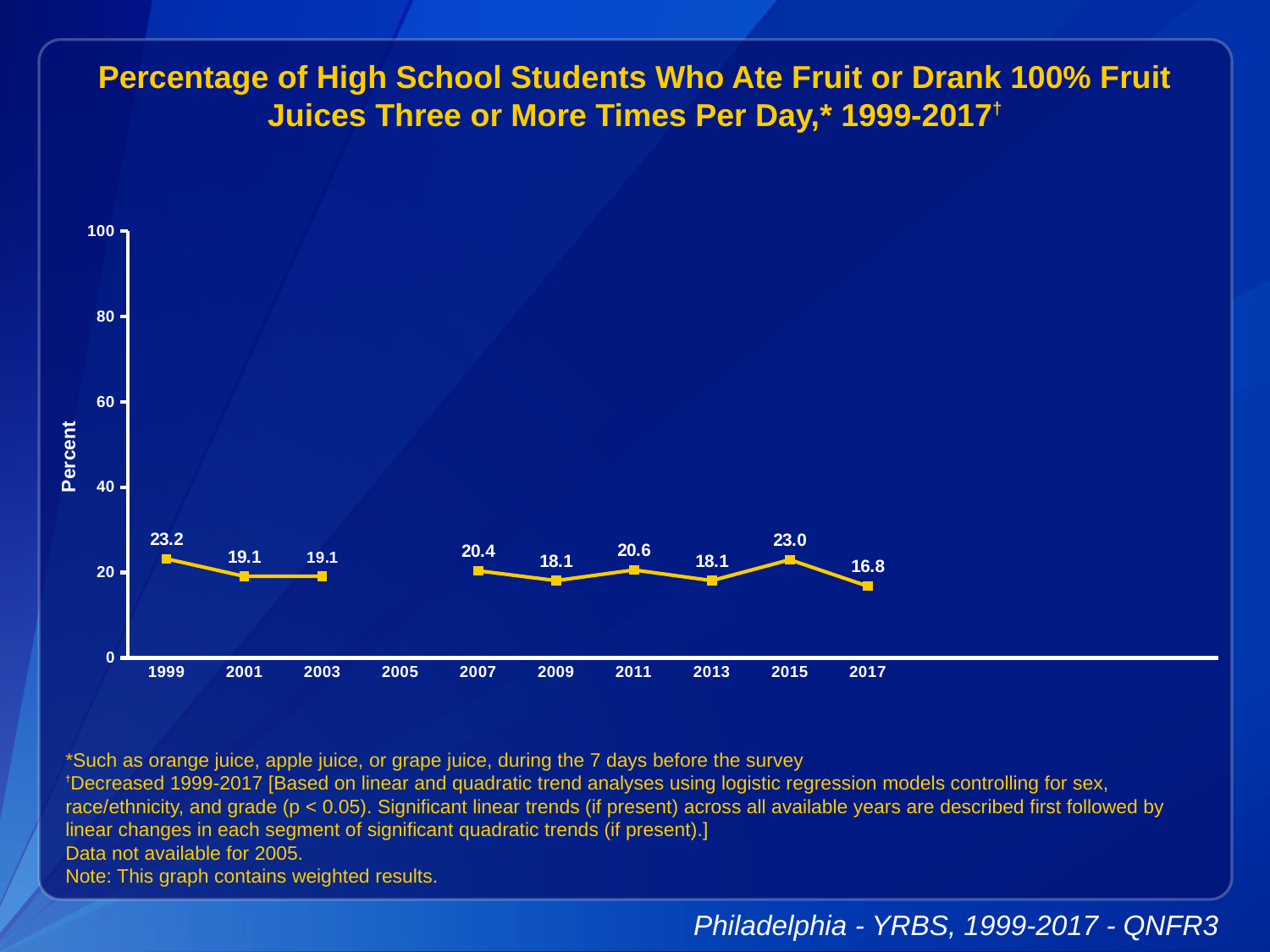
What is the value for 1999? 23.2 What is the difference between the values for 1999 and 2017? 6.4 What is the value for 2015? 23.0 Which is larger, the value for 2007 or the value for 2009? 2007 What kind of chart is shown on the slide? line chart What is the label on the y axis? Percent Which year has the lowest value? 2017 How many years have data points plotted on the chart? 9 Is the value for 2011 greater or less than 40? less Which year has the highest value? 1999 What is the value for 2017? 16.8 Does the value rise or fall from 2015 to 2017? fall